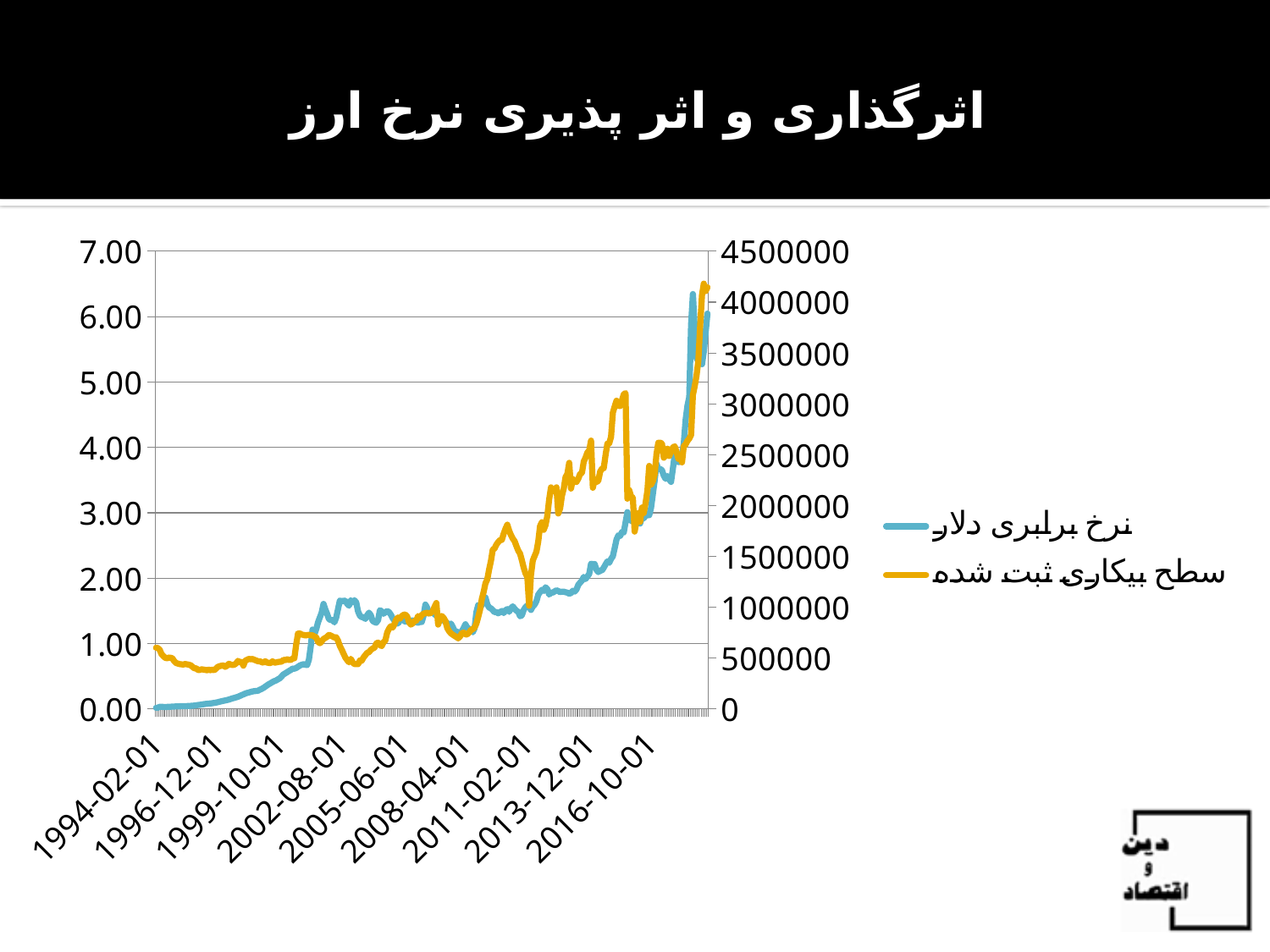
Is the final value of the blue line (نرخ برابری دلار) at the right end of the chart greater or less than 5.00? greater Which series is drawn in blue? نرخ برابری دلار Does the blue line (نرخ برابری دلار) generally rise or fall from 1994 to the end of the series? rise What kind of chart is shown on the slide? line chart Is the final value of the orange line (سطح بیکاری ثبت شده) at the right end of the chart greater or less than 3500000 on the right axis? greater How many series does the legend list? 2 What is the highest tick value shown on the right vertical axis? 4500000 Which series is drawn in orange? سطح بیکاری ثبت شده Is the value of the orange line (سطح بیکاری ثبت شده) at 1994-02-01 greater or less than 1000000 on the right axis? less What is the highest tick value shown on the left vertical axis? 7.00 How many date labels are shown on the x axis? 9